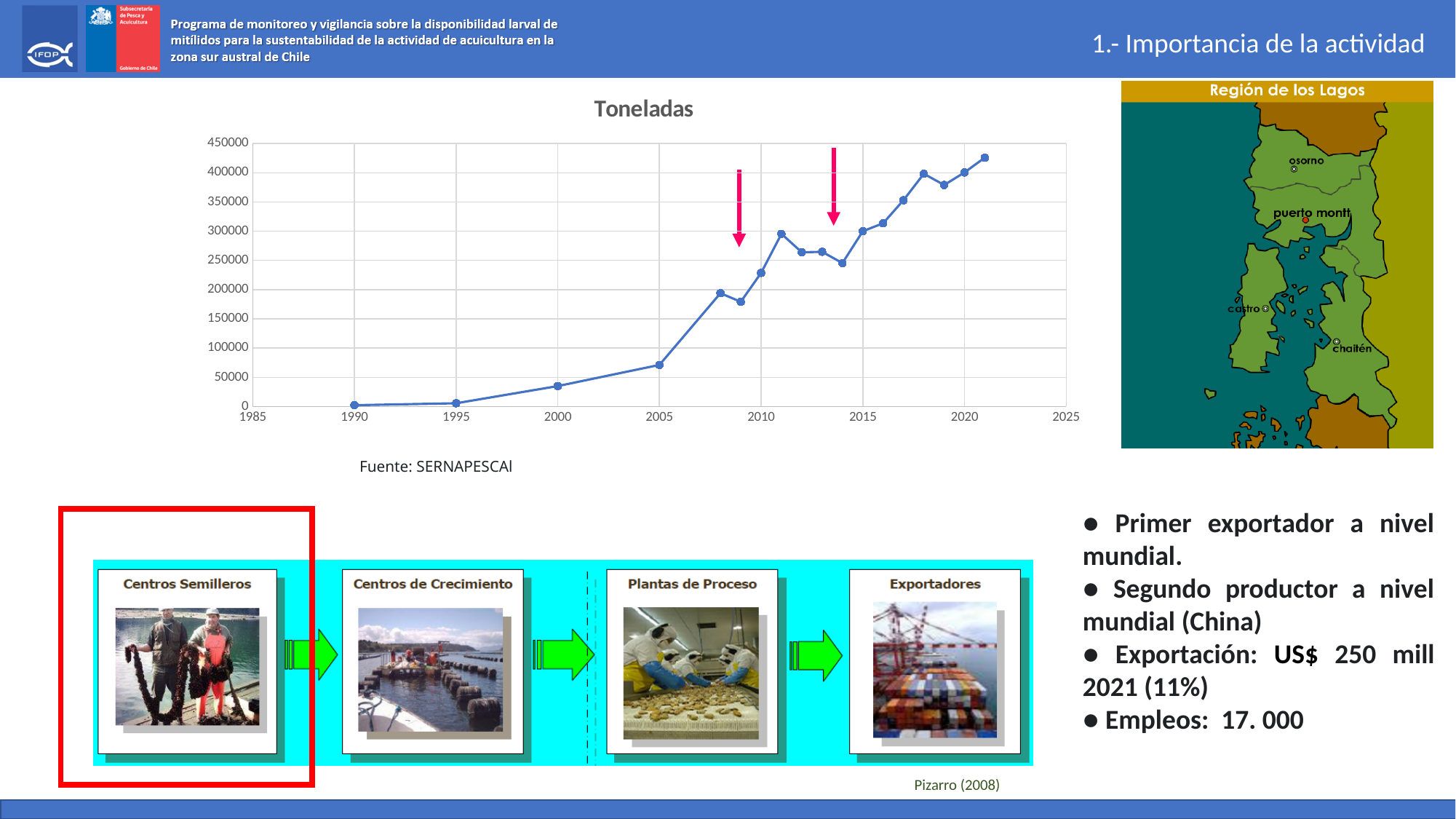
Which year has the highest value in the Toneladas chart? 2021 What kind of chart is shown on the slide? line chart Is the value for 2017 greater or less than 300000? greater Is the value for 2000 greater or less than 50000? less Which year has the lowest value in the Toneladas chart? 1990 Is the value for 2005 greater or less than 100000? less Which year has the larger value, 2011 or 2014? 2011 What is the title of the chart? Toneladas Overall, do the values in the Toneladas chart rise or fall from 1990 to 2021? rise What source is cited below the chart? SERNAPESCA